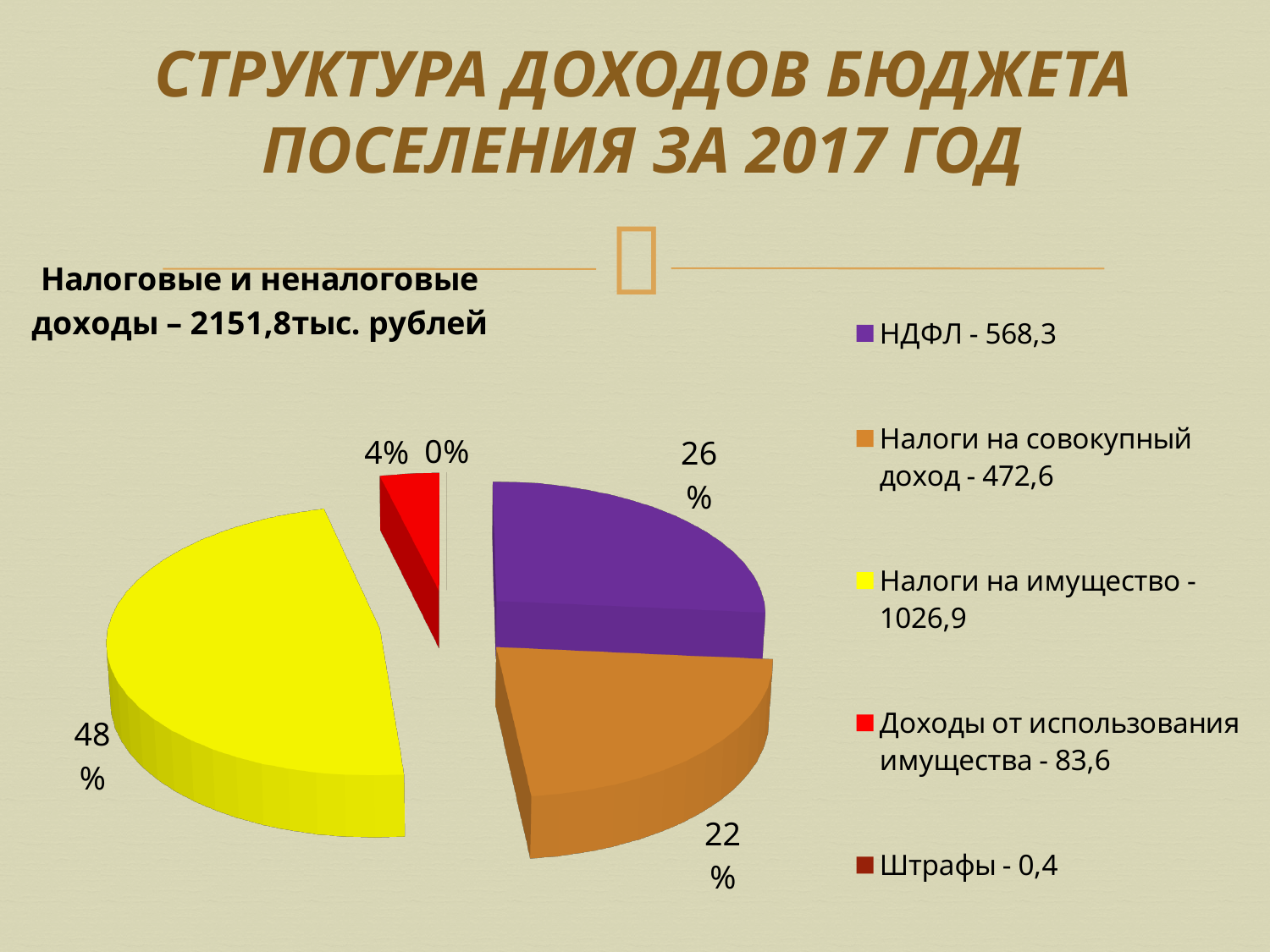
What share of the pie does Доходы от использования имущества take? 4% What share of the pie does Налоги на совокупный доход take? 22% What share of the pie does Налоги на имущество take? 48% What value does the legend give for Налоги на имущество? 1026,9 Which slice is larger: НДФЛ or Налоги на совокупный доход? НДФЛ How many categories does the legend list? 5 What is the difference in percentage points between the shares of Налоги на имущество and НДФЛ? 22 Which category has the largest slice of the pie? Налоги на имущество What kind of chart is shown on the slide? pie chart Which category has the smallest slice of the pie? Штрафы